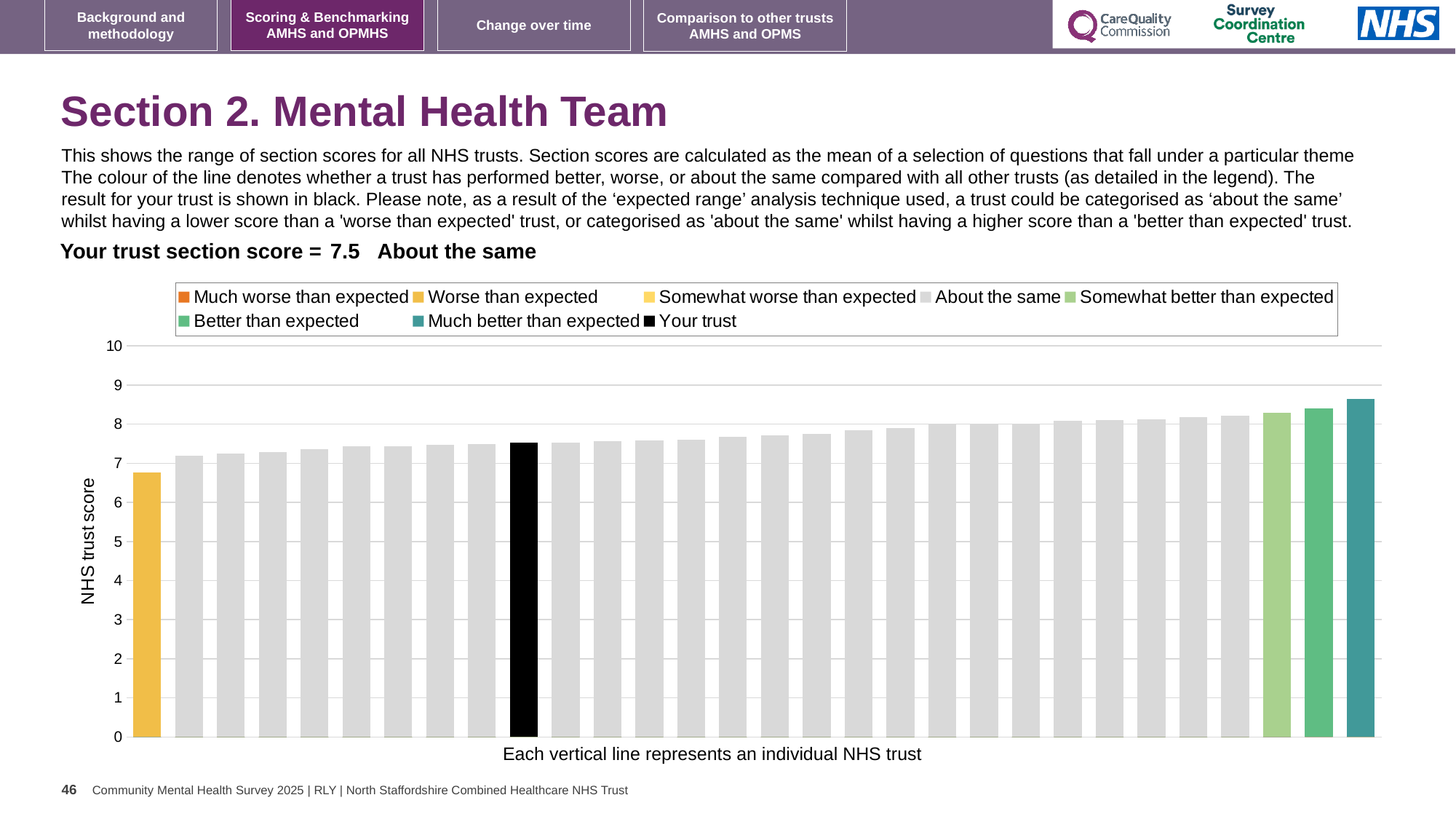
Which is larger, the rightmost bar or the leftmost bar? the rightmost bar What is the section score for your trust shown on the slide? 7.5 Which legend category does the highest bar in the chart belong to? Much better than expected What colour is the bar representing your trust? black Is the value of the highest (rightmost) bar greater or less than 8? greater What is the label on the vertical axis of the chart? NHS trust score Is the value of the lowest (leftmost) bar greater or less than 7? less Which legend category does the lowest bar in the chart belong to? Worse than expected What kind of chart is shown on the slide? bar chart How many entries does the chart legend list? 8 Do the bar values rise or fall from left to right along the x axis? rise Is the value of the highest (rightmost) bar greater or less than 9? less